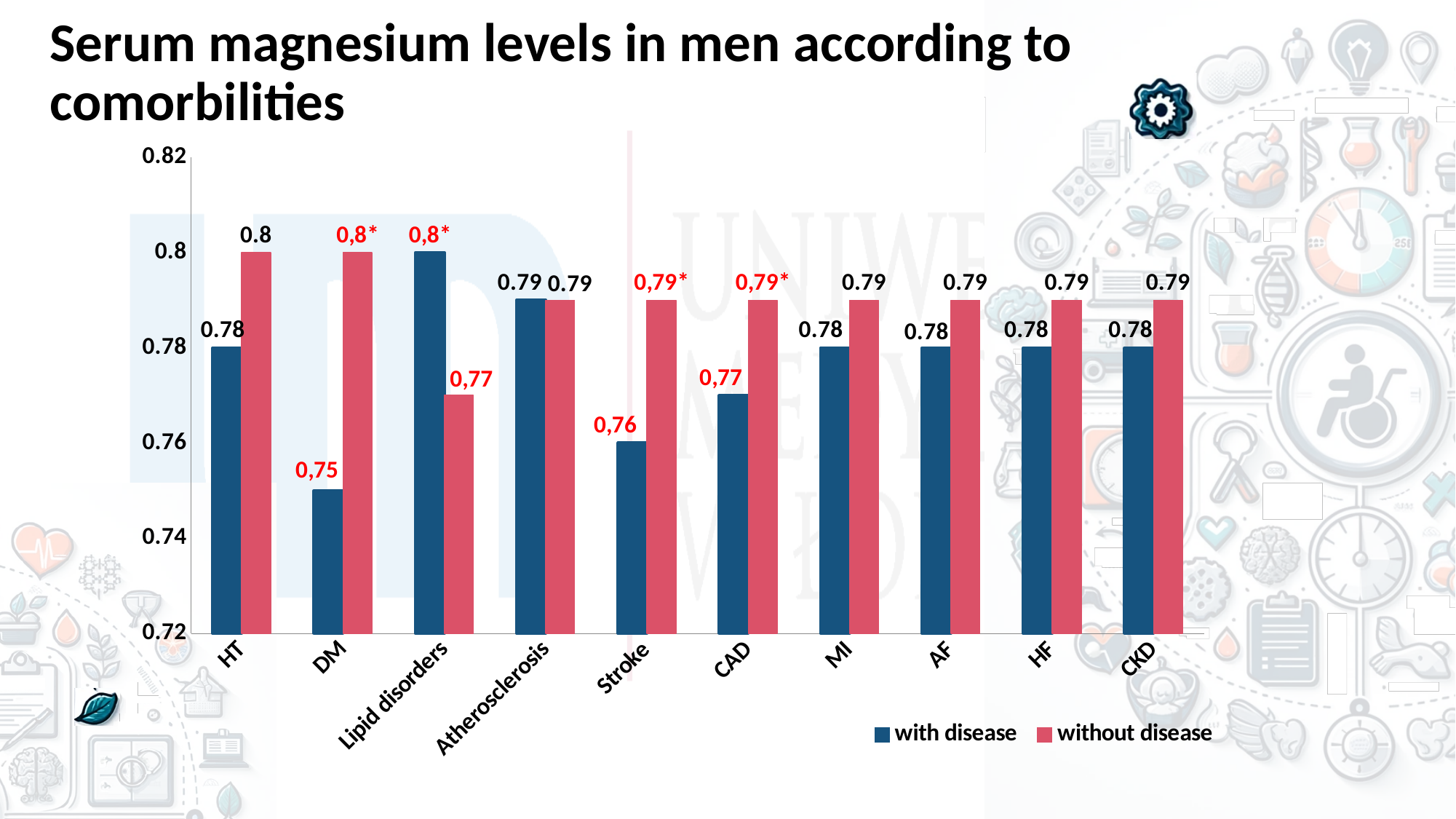
What is the serum magnesium level for men with disease in the HT category? 0.78 In the DM category, which is larger: the value with disease or without disease? without disease Which category has the lowest value for the 'with disease' series? DM What is the difference between the 'without disease' and 'with disease' values for HT? 0.02 How many series does the legend list? 2 What is the value for men without disease in the DM category? 0,8* What kind of chart is shown on the slide? bar chart What is the value for men without disease in the Lipid disorders category? 0,77 How many comorbidity categories are shown on the x axis? 10 What is the value for men with disease in the Stroke category? 0,76 Which category has the highest value for the 'with disease' series? Lipid disorders Which category has the lowest value for the 'without disease' series? Lipid disorders